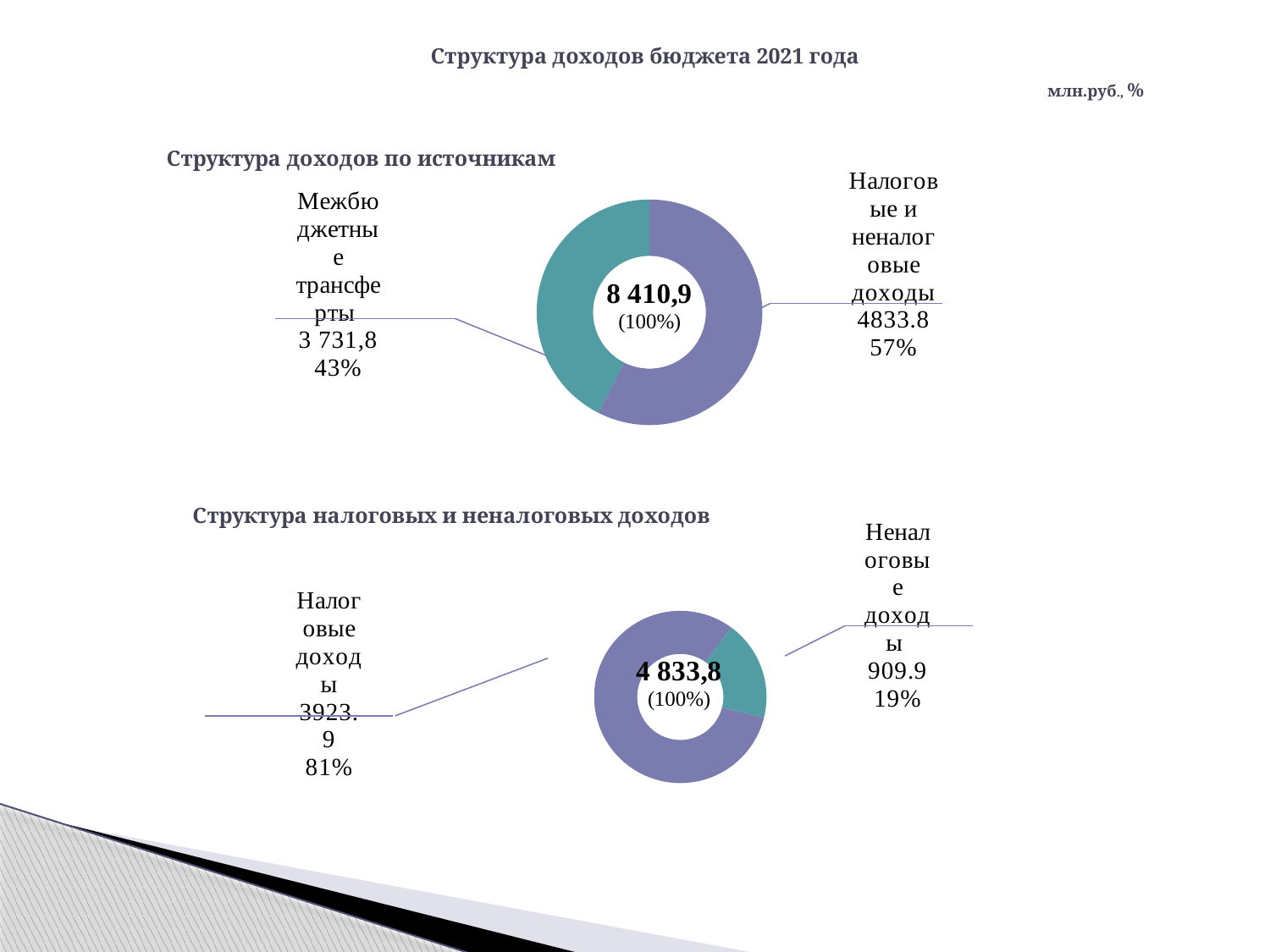
In the top chart 'Структура доходов по источникам', how many categories are shown? 2 In the top chart 'Структура доходов по источникам', what total value is shown in the centre of the doughnut? 8 410,9 In the top chart 'Структура доходов по источникам', what is the value for Межбюджетные трансферты? 3 731,8 In the bottom chart 'Структура налоговых и неналоговых доходов', which is larger: Налоговые доходы or Неналоговые доходы? Налоговые доходы In the bottom chart 'Структура налоговых и неналоговых доходов', what total value is shown in the centre of the doughnut? 4 833,8 In the top chart 'Структура доходов по источникам', which category is the largest? Налоговые и неналоговые доходы What is the title of the slide above the two charts? Структура доходов бюджета 2021 года In the top chart 'Структура доходов по источниками', what share of the total do Налоговые и неналоговые доходы make up? 57% In the bottom chart 'Структура налоговых и неналоговых доходов', what is the value for Неналоговые доходы? 909.9 In the bottom chart 'Структура налоговых и неналоговых доходов', which category is the smallest? Неналоговые доходы What kind of chart is the top chart 'Структура доходов по источникам'? Doughnut chart In the bottom chart 'Структура налоговых и неналоговых доходов', what share of the total do Налоговые доходы make up? 81%